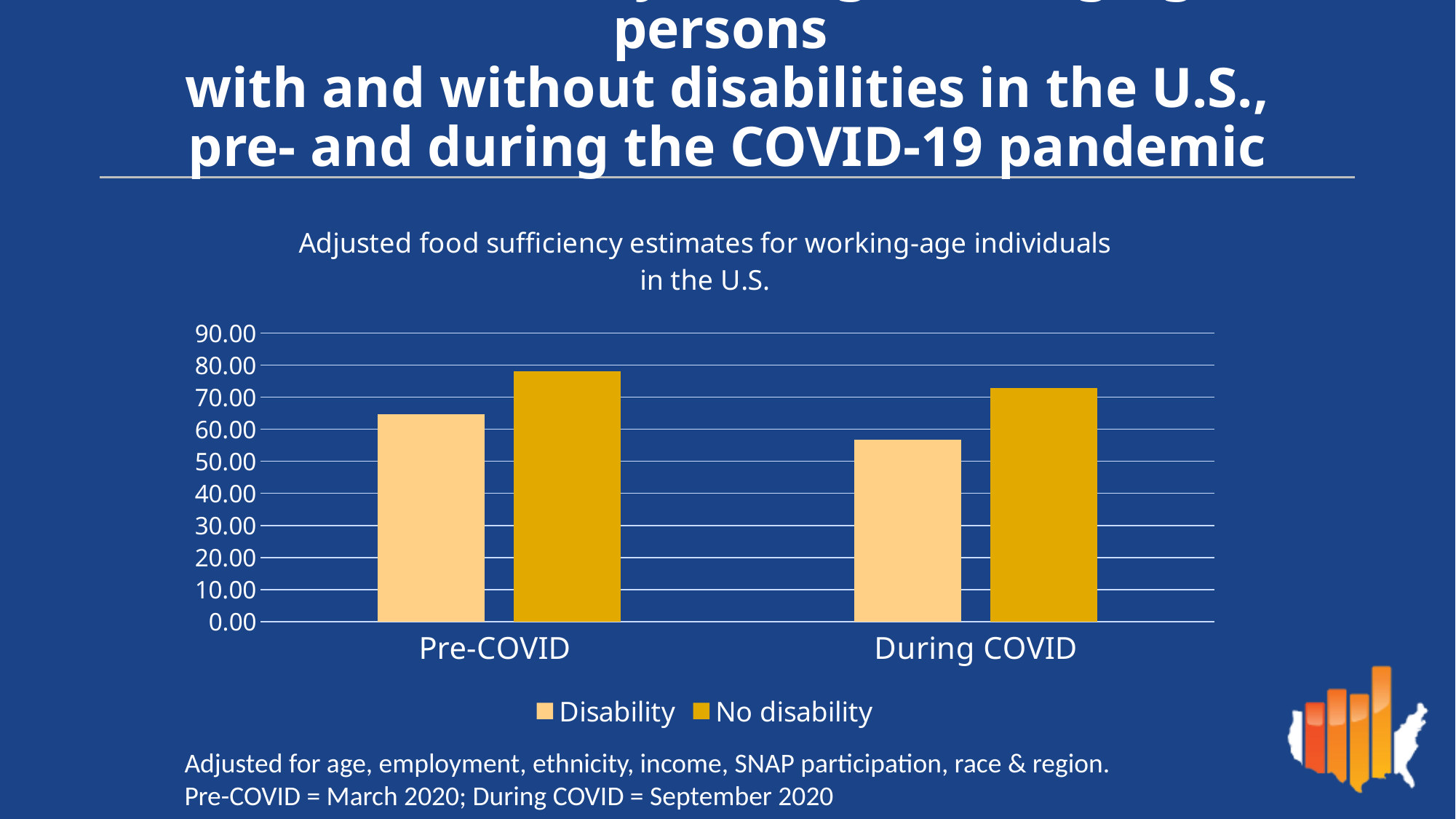
Is the value for Disability in the Pre-COVID period greater or less than 60.00? greater How many series does the legend list? 2 Which bar is the lowest in the chart? Disability, During COVID Do the values for the No disability series rise or fall from Pre-COVID to During COVID? fall What are the two series named in the legend? Disability and No disability Is the value for No disability in the Pre-COVID period greater or less than 70.00? greater Which is larger: the Disability value Pre-COVID or the Disability value During COVID? Pre-COVID Which bar is the highest in the chart? No disability, Pre-COVID How many categories are shown on the x axis? 2 What is the title of the chart? Adjusted food sufficiency estimates for working-age individuals in the U.S. Is the value for Disability in the During COVID period greater or less than 60.00? less What kind of chart is shown on the slide? Bar chart